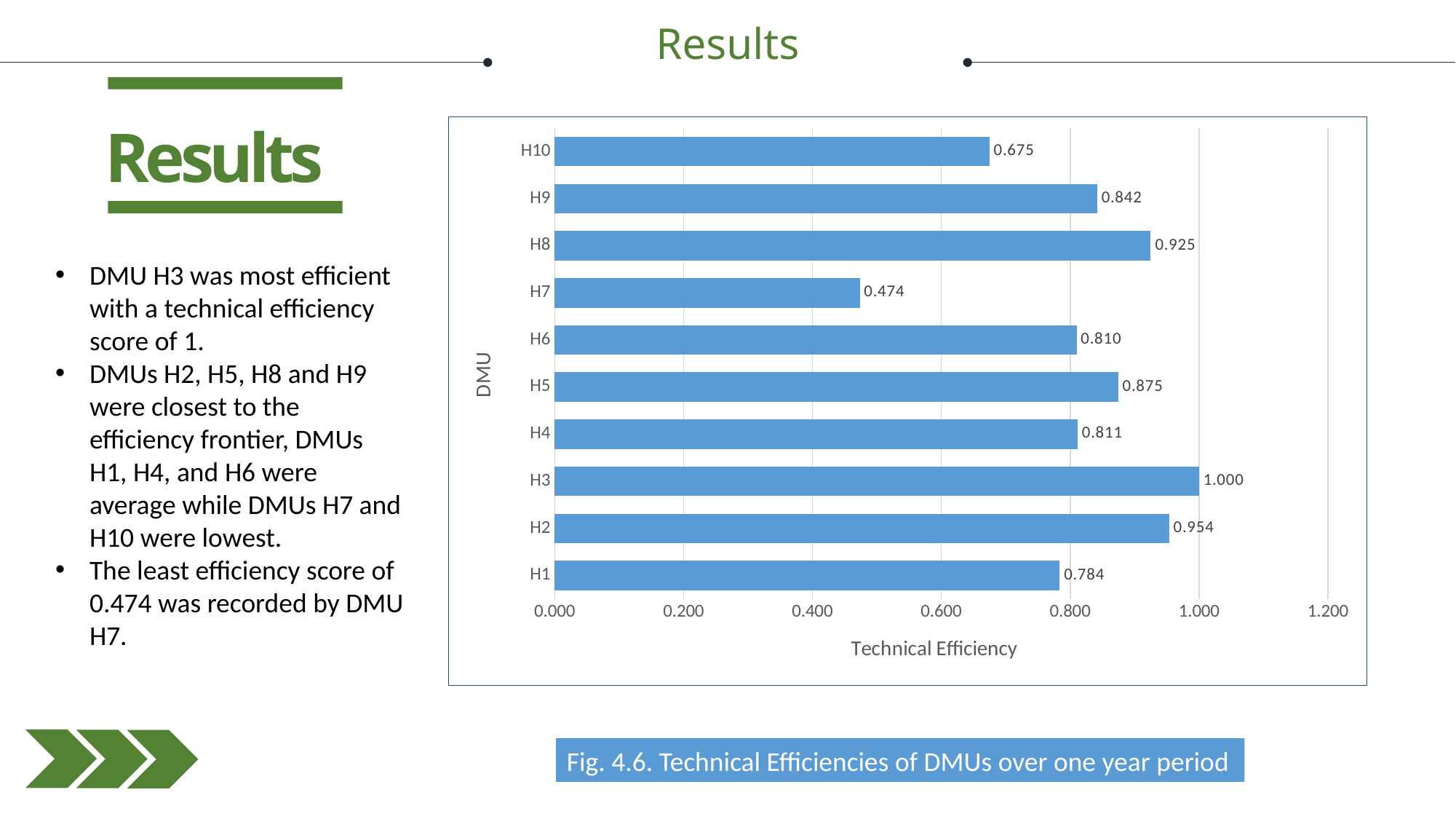
What is the technical efficiency value for DMU H7? 0.474 What is the technical efficiency value for DMU H3? 1.000 What is the technical efficiency value for DMU H10? 0.675 Which DMU has the highest technical efficiency? H3 Is the value for H1 greater or less than 0.800? less What is the difference between the technical efficiency of H2 and H9? 0.112 Which DMU has the lowest technical efficiency? H7 What kind of chart is shown on the slide? bar chart Which has a higher technical efficiency, H8 or H5? H8 How many DMUs are shown in the chart? 10 What is the caption of the figure shown on the slide? Fig. 4.6. Technical Efficiencies of DMUs over one year period What is the label of the horizontal axis of the chart? Technical Efficiency